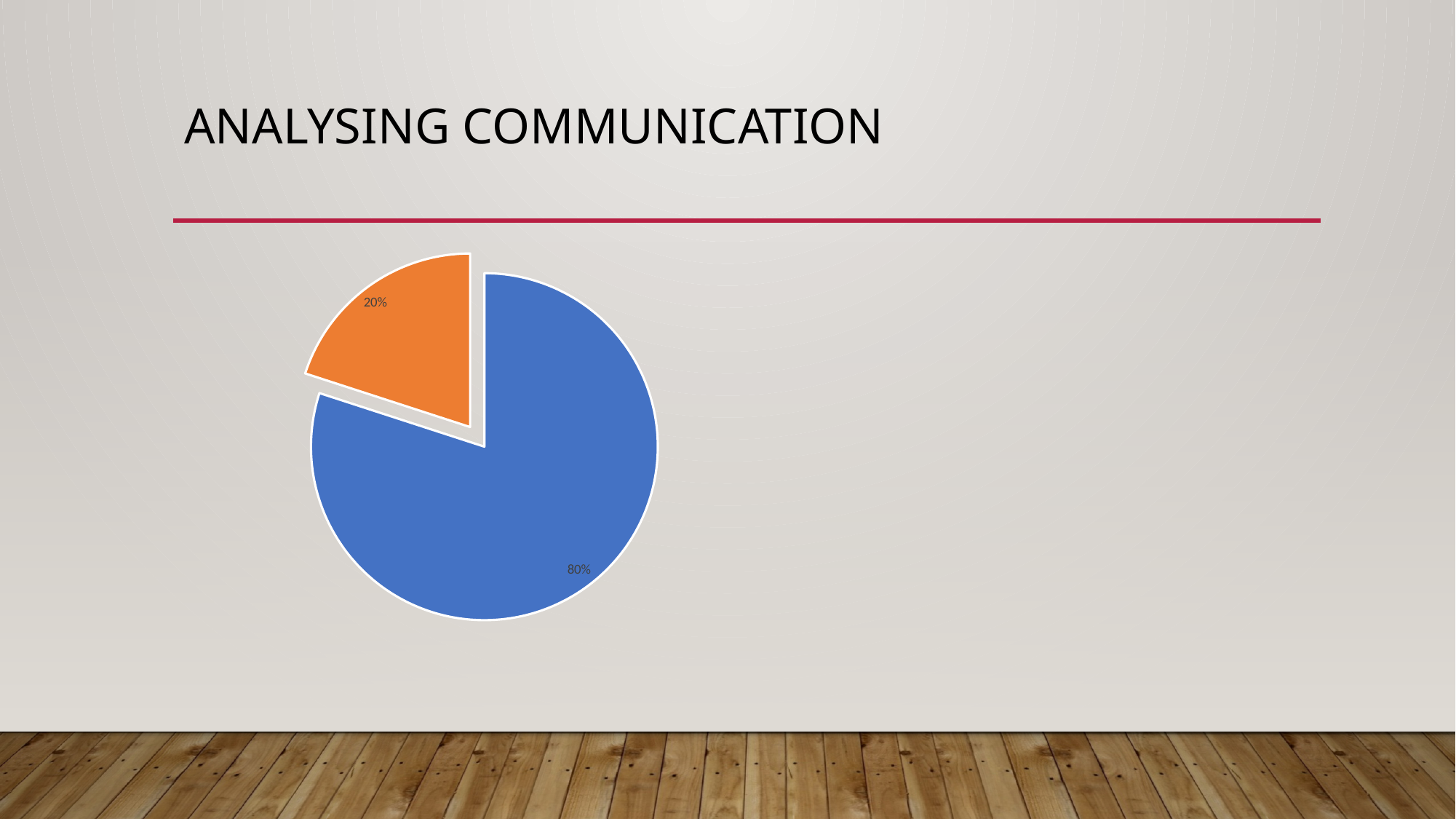
What share of the pie does the orange slice represent? 20% What is the difference in percentage points between the blue slice and the orange slice? 60 Which slice of the pie chart is pulled out (exploded) from the rest of the pie? the orange slice What percentage is shown on the blue slice of the pie chart? 80% Which slice of the pie chart is the smallest? the orange slice How many slices does the pie chart have? 2 Which slice of the pie chart is the largest? the blue slice What is the title of the slide containing the pie chart? ANALYSING COMMUNICATION What kind of chart is shown on the slide? pie chart What percentage is shown on the orange slice of the pie chart? 20% Which slice is larger, the blue slice or the orange slice? the blue slice